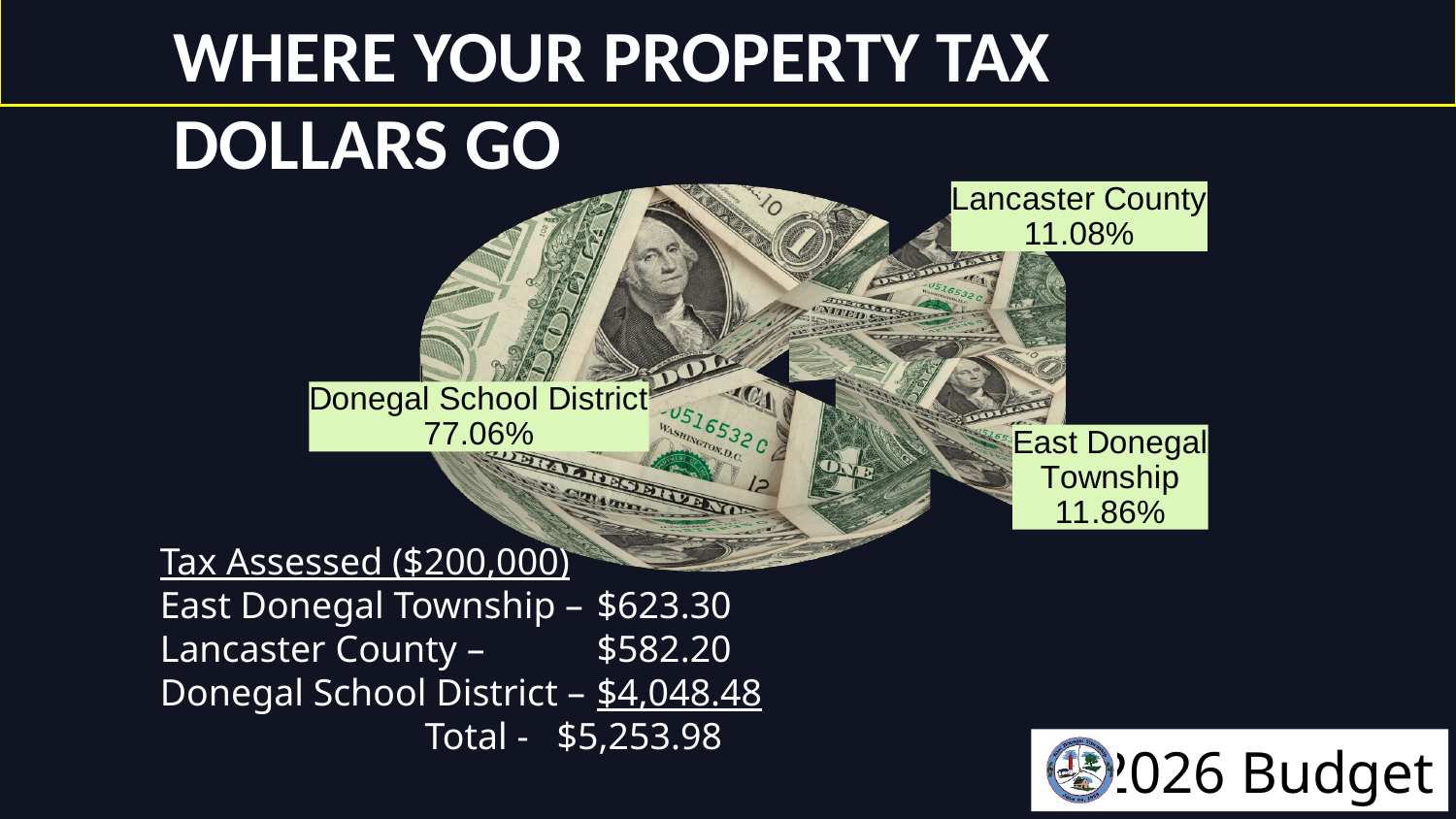
What share of the pie chart does East Donegal Township represent? 11.86% Which slice of the pie chart is the smallest? Lancaster County What is the difference in percentage points between the Donegal School District slice and the East Donegal Township slice? 65.20 What is the difference in percentage points between the East Donegal Township slice and the Lancaster County slice? 0.78 How many slices does the pie chart have? 3 Is the share for Donegal School District greater or less than 50%? greater What image is used to fill the slices of the pie chart? dollar bills What kind of chart is shown on the slide? pie chart Which slice of the pie chart is the largest? Donegal School District What is the title of the slide containing the pie chart? WHERE YOUR PROPERTY TAX DOLLARS GO What share of the pie chart does Donegal School District represent? 77.06% What share of the pie chart does Lancaster County represent? 11.08%